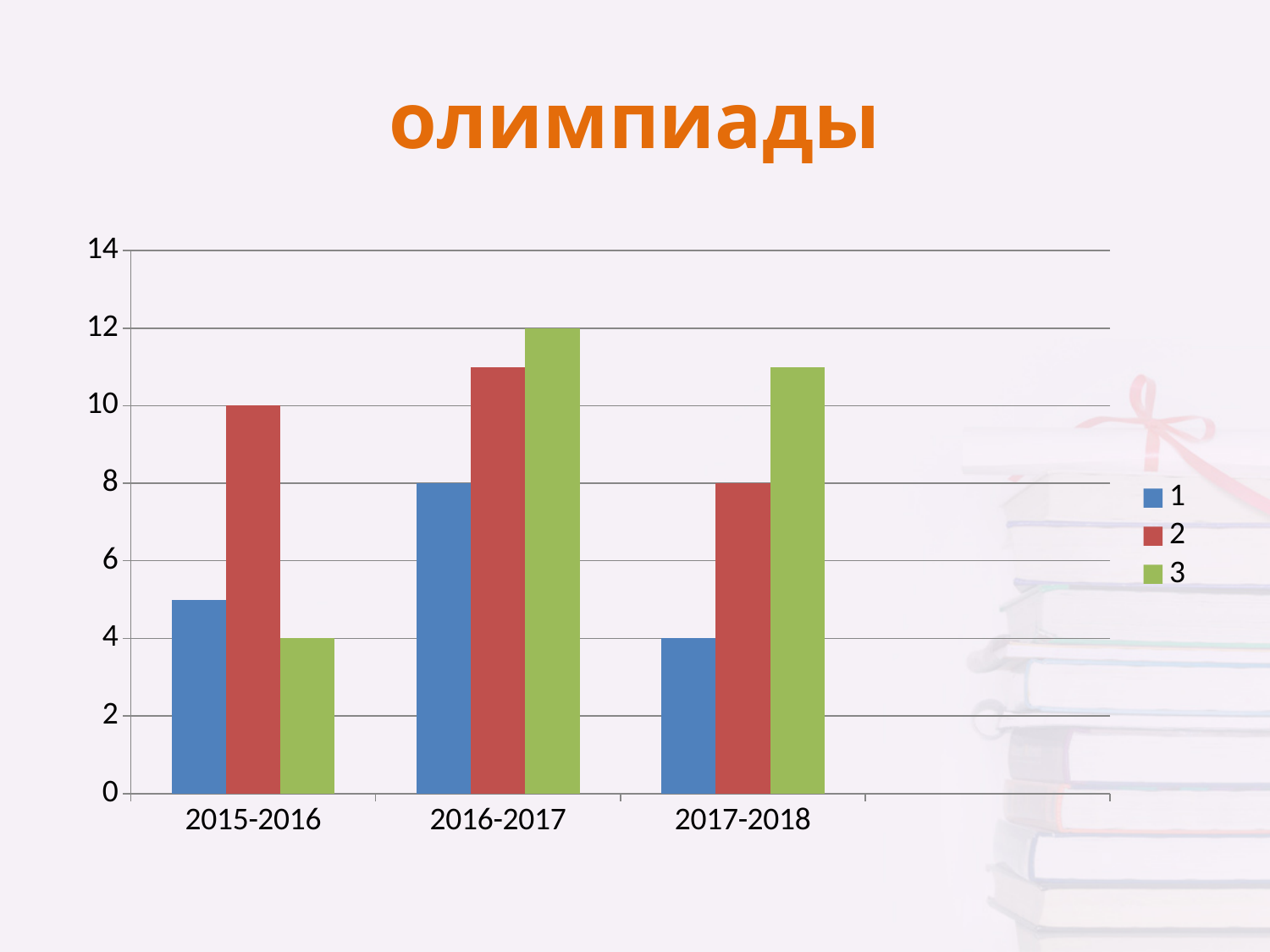
What is the value for series 2 in 2015-2016? 10 Which series has the highest value in 2016-2017? 3 Which is larger in 2015-2016: the value for series 2 or the value for series 3? series 2 Is the value for series 2 in 2016-2017 greater or less than 10? greater How many series does the legend list? 3 How many categories are shown on the x axis? 3 Which series has the lowest value in 2017-2018? 1 What is the value for series 3 in 2016-2017? 12 What is the value for series 1 in 2017-2018? 4 What kind of chart is shown on the slide? bar chart What is the difference between the value for series 3 in 2016-2017 and the value for series 3 in 2015-2016? 8 What is the value for series 2 in 2017-2018? 8